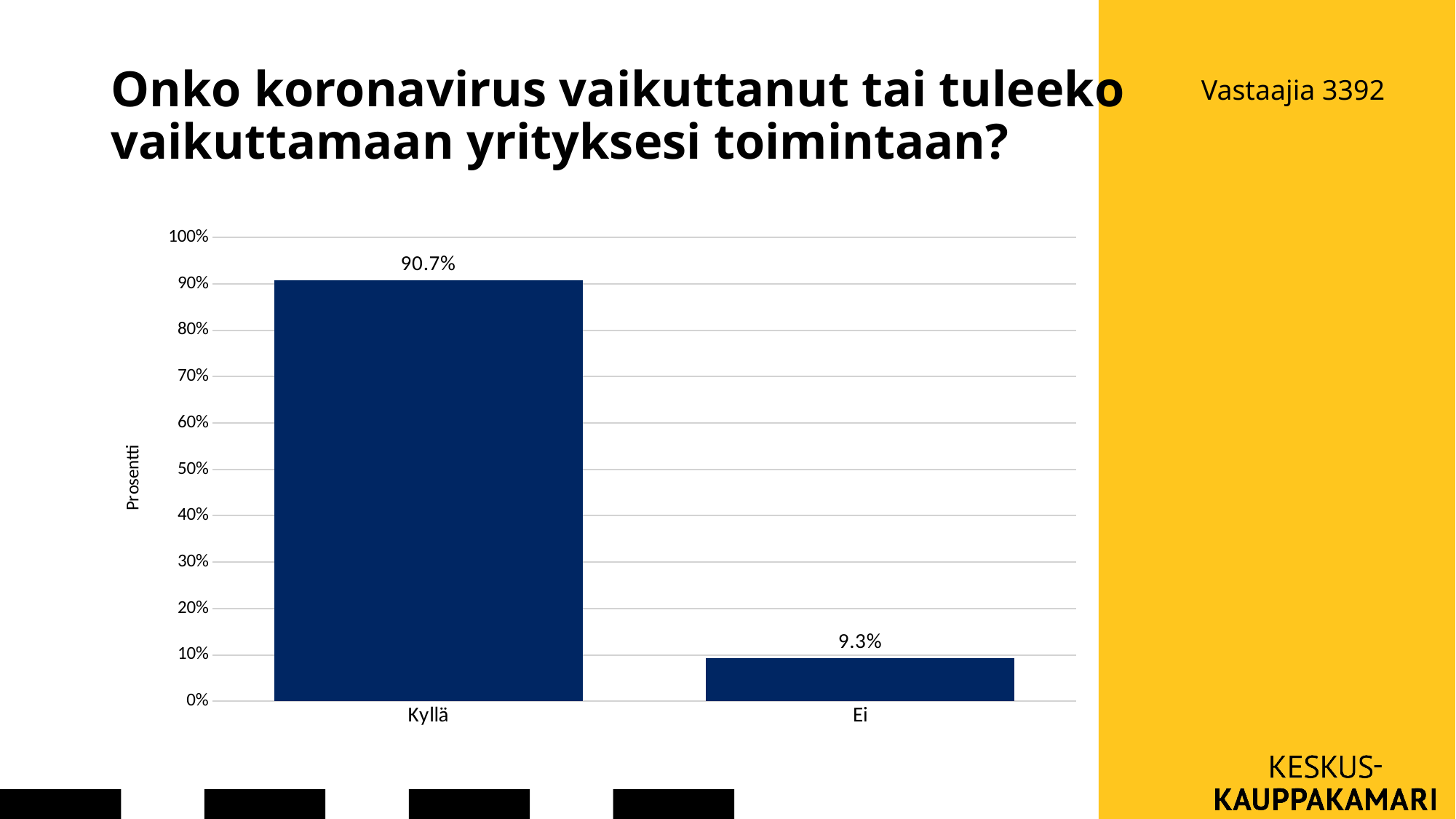
What is the label of the y axis? Prosentti What is the value for Kyllä? 90.7% What is the value for Ei? 9.3% How many categories are shown on the x axis? 2 Which category has the highest value? Kyllä How many respondents (Vastaajia) are stated on the slide? 3392 Is the value for Ei greater or less than 10%? less Is the value for Kyllä greater or less than 90%? greater What kind of chart is shown on the slide? bar chart Which is larger, the value for Kyllä or the value for Ei? Kyllä What is the difference between the values for Kyllä and Ei? 81.4% Which category has the lowest value? Ei